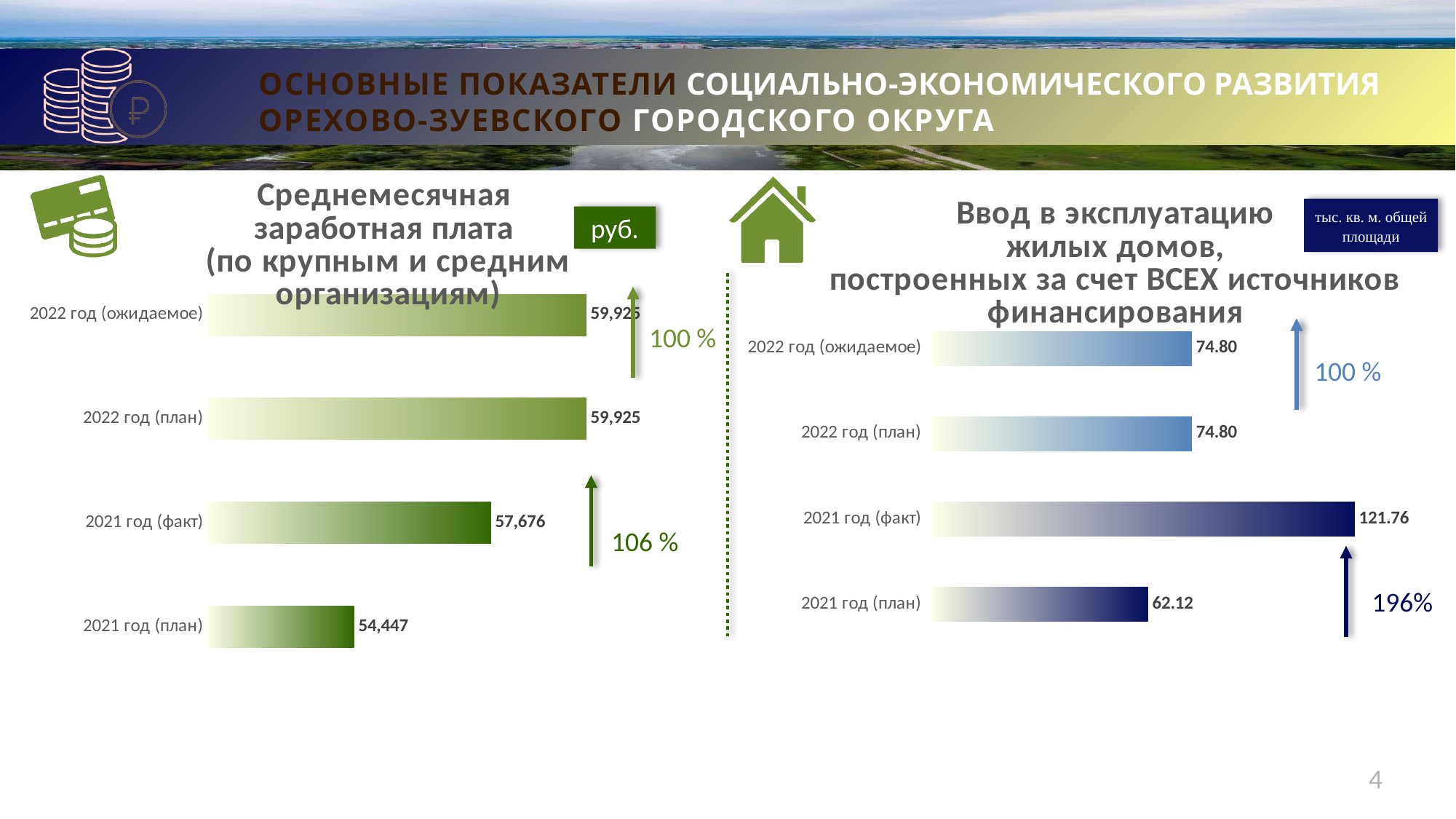
In the right chart (Ввод в эксплуатацию жилых домов), what is the value for 2021 год (план)? 62.12 In the left chart (Среднемесячная заработная плата), what is the value for 2021 год (факт)? 57,676 In the left chart (Среднемесячная заработная плата), what is the difference between 2021 год (факт) and 2021 год (план)? 3,229 In the left chart (Среднемесячная заработная плата), which category has the lowest value? 2021 год (план) What type of chart is the right chart (Ввод в эксплуатацию жилых домов)? Bar chart In the left chart (Среднемесячная заработная плата), how many bars are shown? 4 In the right chart (Ввод в эксплуатацию жилых домов), which category has the highest value? 2021 год (факт) In the right chart (Ввод в эксплуатацию жилых домов), what is the value for 2021 год (факт)? 121.76 In the right chart (Ввод в эксплуатацию жилых домов), what is the difference between 2021 год (факт) and 2021 год (план)? 59.64 In the right chart (Ввод в эксплуатацию жилых домов), which is larger: 2021 год (факт) or 2022 год (план)? 2021 год (факт) In the left chart (Среднемесячная заработная плата), what is the value for 2022 год (план)? 59,925 In the left chart (Среднемесячная заработная плата), what is the value for 2021 год (план)? 54,447